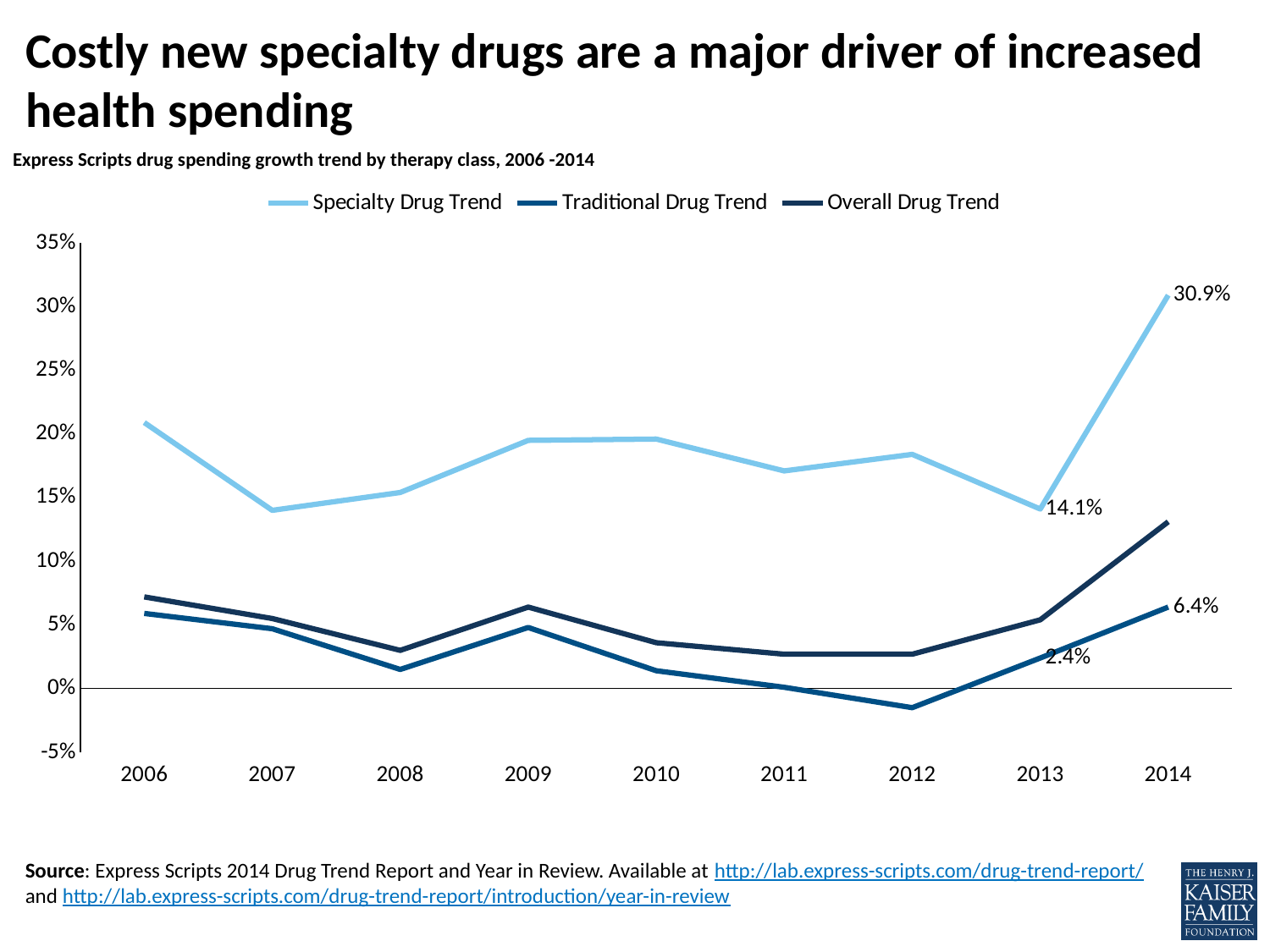
What is the Traditional Drug Trend value for 2013? 2.4% What is the Specialty Drug Trend value for 2013? 14.1% What is the difference between the Specialty Drug Trend and the Traditional Drug Trend in 2014? 24.5 percentage points How many years are shown on the x axis? 9 Is the Traditional Drug Trend value for 2012 greater or less than 0%? less How many series does the legend list? 3 What is the Traditional Drug Trend value for 2014? 6.4% Which is larger in 2014, the Specialty Drug Trend or the Traditional Drug Trend? Specialty Drug Trend Is the Overall Drug Trend value for 2014 greater or less than 10%? greater What is the Specialty Drug Trend value for 2014? 30.9% What kind of chart is shown on the slide? Line chart By how many percentage points did the Specialty Drug Trend increase from 2013 to 2014? 16.8 percentage points